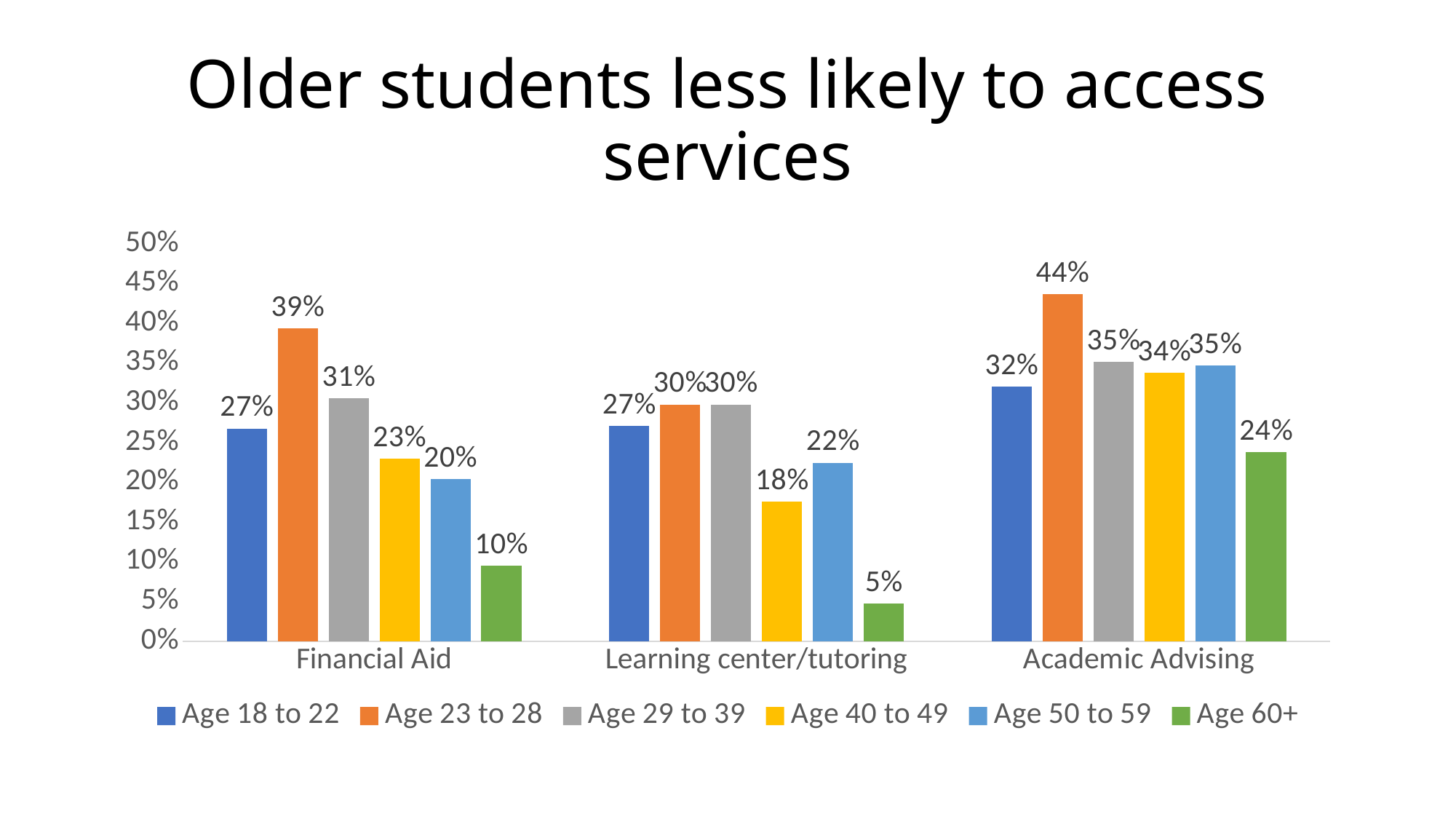
What is the value for Age 40 to 49 in the Academic Advising category? 34% What is the title of the slide? Older students less likely to access services Which is larger for Learning center/tutoring: the value for Age 40 to 49 or the value for Age 50 to 59? Age 50 to 59 How many service categories are shown on the x axis? 3 What is the difference between the Age 23 to 28 and Age 60+ values for Academic Advising? 20% How many age groups does the legend list? 6 What kind of chart is shown on the slide? Bar chart Which colour represents Age 60+ in the chart? Green What percentage of students aged 23 to 28 accessed Financial Aid? 39% Which age group has the lowest value for Financial Aid? Age 60+ What is the value for Age 60+ in the Learning center/tutoring category? 5% Which age group has the highest value for Academic Advising? Age 23 to 28